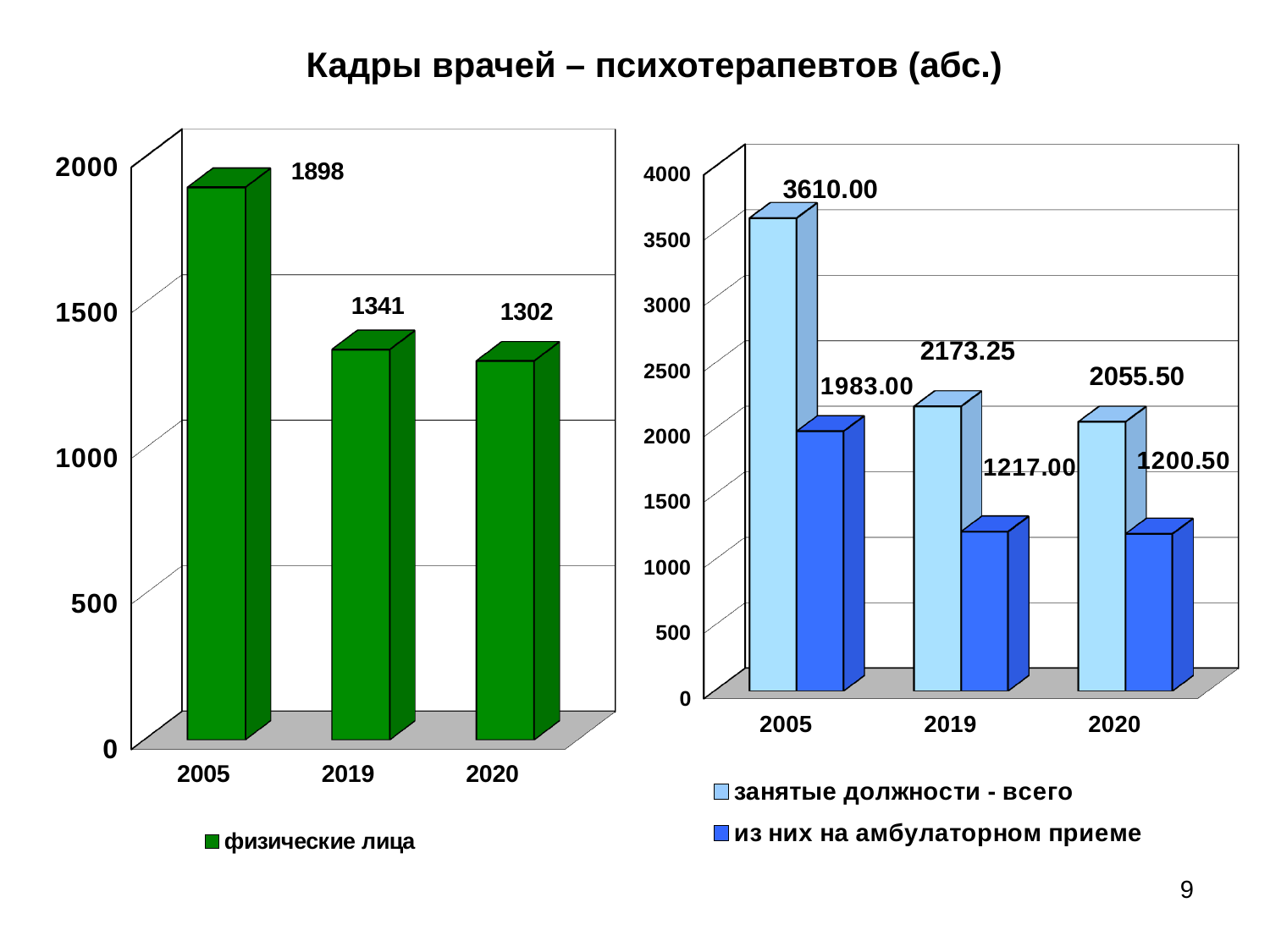
What kind of chart is the left chart? bar chart In the right chart, what is the difference between занятые должности - всего and из них на амбулаторном приеме in 2019? 956.25 In the right chart, what is the value of занятые должности - всего for 2005? 3610.00 In the left chart, what is the value for 2020? 1302 In the right chart, which is larger: из них на амбулаторном приеме in 2005 or in 2019? 2005 In the right chart, what is the value of из них на амбулаторном приеме for 2020? 1200.50 In the left chart, what is the difference between the 2005 and 2019 values? 557 How many series does the legend of the right chart list? 2 In the left chart, what is the value for 2005 for физические лица? 1898 In the right chart, which year has the lowest value for занятые должности - всего? 2020 In the left chart, which year has the highest value? 2005 In the left chart, do the values rise or fall from 2005 to 2020? fall